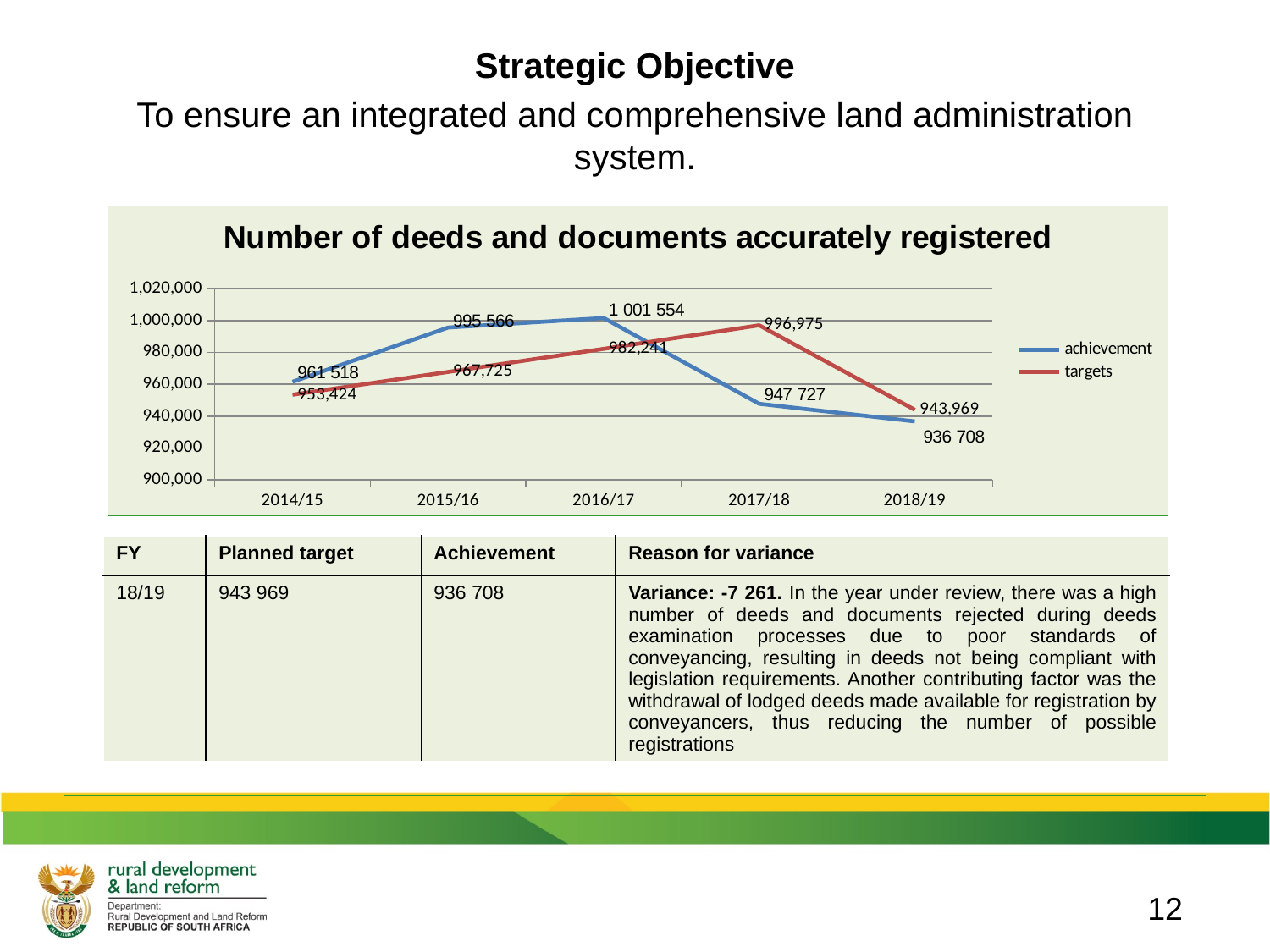
How many financial years are shown on the x axis? 5 By how much does the target exceed the achievement in 2018/19? 7 261 What is the targets value for 2017/18? 996,975 What is the achievement value for 2018/19? 936 708 In which year is the achievement series highest? 2016/17 In 2014/15, which is larger: achievement or targets? achievement In which year is the targets series highest? 2017/18 What is the achievement value for 2016/17? 1 001 554 What kind of chart is shown? line chart In which year is the achievement series lowest? 2018/19 How many series does the legend list? 2 In 2017/18, which is larger: achievement or targets? targets